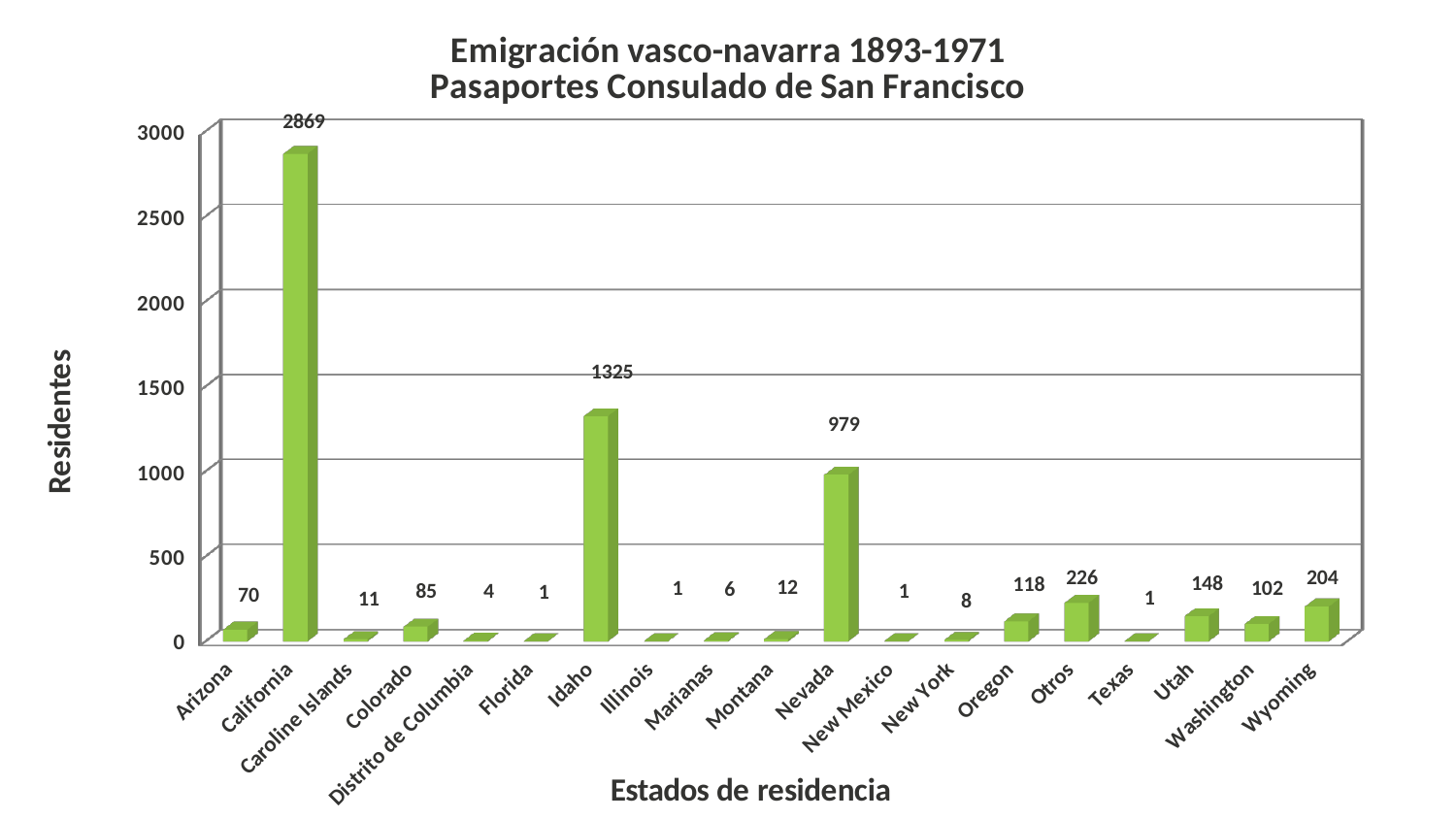
Is the value for Nevada greater or less than 1000? less What is the value for Idaho? 1325 What kind of chart is shown on the slide? bar chart What is the difference between the values for Otros and Utah? 78 What is the value for Nevada? 979 Which is larger, the value for Oregon or the value for Washington? Oregon What is the value for Wyoming? 204 What is the difference between the values for California and Idaho? 1544 How many categories are shown on the x axis? 19 Which state has the highest number of residents? California What is the value for California? 2869 What is the label of the y axis? Residentes